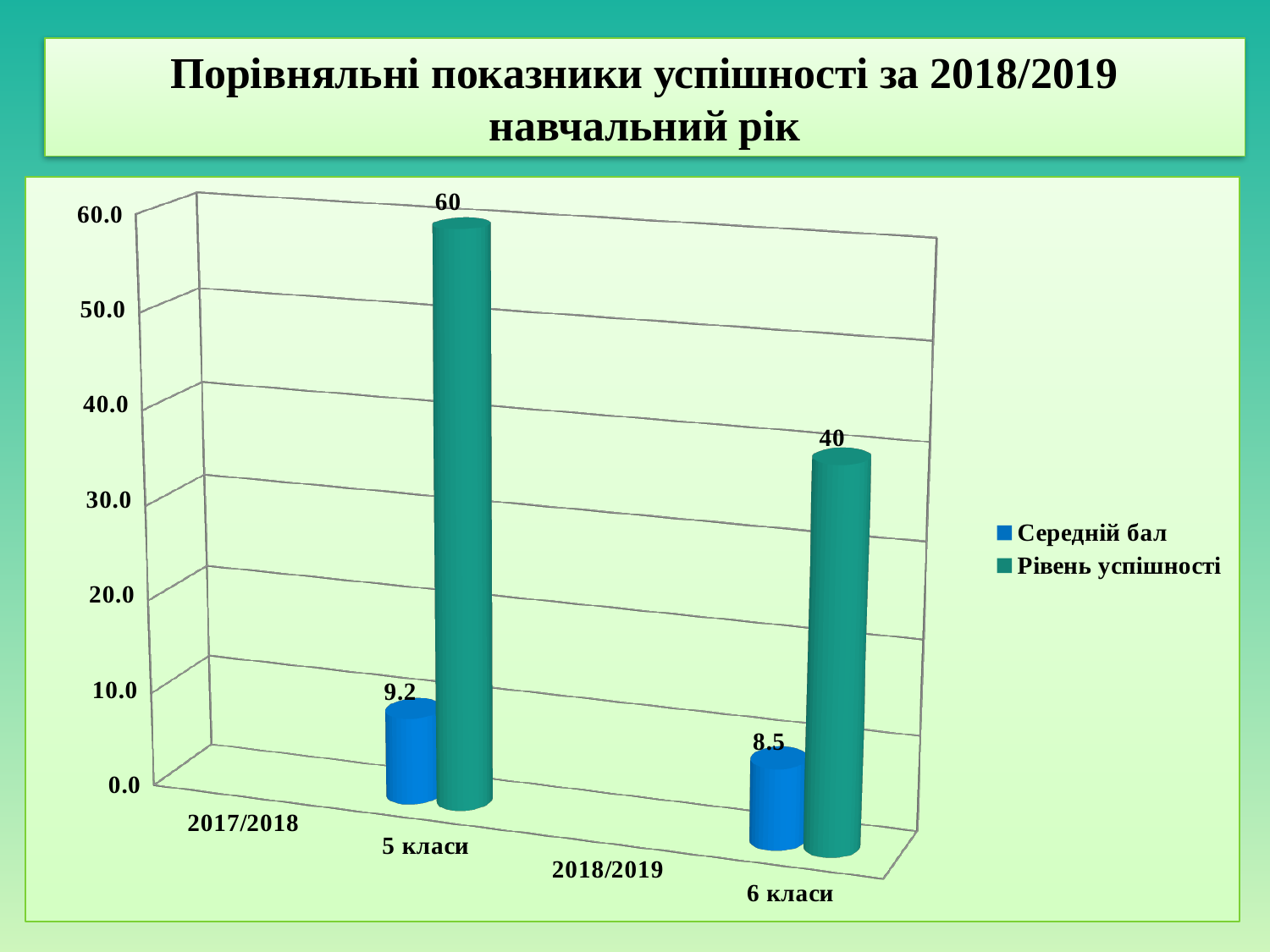
Does Рівень успішності rise or fall from 2017/2018 5 класи to 2018/2019 6 класи? Fall What is the value of Рівень успішності for 2017/2018 5 класи? 60 How many categories are shown on the x axis? 4 Which is larger: Середній бал for 2017/2018 5 класи or for 2018/2019 6 класи? 2017/2018 5 класи Which category has the highest Рівень успішності? 2017/2018 5 класи What is the value of Рівень успішності for 2018/2019 6 класи? 40 How many series does the legend list? 2 Which category has the lowest Середній бал? 2018/2019 6 класи What is the value of Середній бал for 2018/2019 6 класи? 8.5 What kind of chart is shown on the slide? Bar chart What is the difference in Рівень успішності between 2017/2018 5 класи and 2018/2019 6 класи? 20 What is the value of Середній бал for 2017/2018 5 класи? 9.2